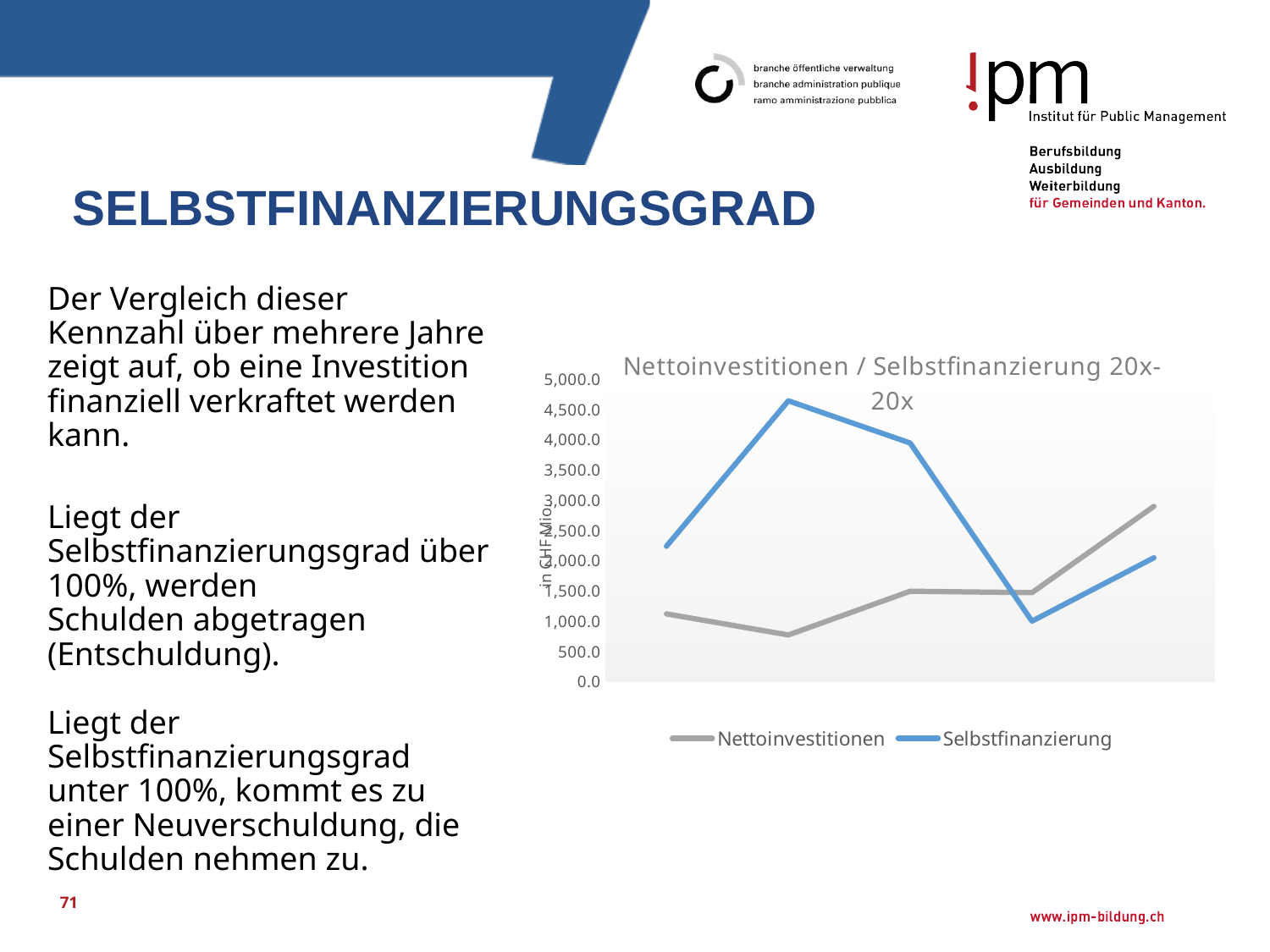
Does the Nettoinvestitionen line end higher or lower than it starts? higher Is the lowest value of the Nettoinvestitionen line greater or less than 1,000? less What are the two series named in the chart legend? Nettoinvestitionen and Selbstfinanzierung At which data point (first to fifth) does the Selbstfinanzierung line reach its highest value? second Is the last value of the Nettoinvestitionen line greater or less than 2,500? greater What kind of chart is shown on the slide? line chart How many data points does each line in the chart have? 5 What is the title of the chart? Nettoinvestitionen / Selbstfinanzierung 20x-20x Is the highest value of the Selbstfinanzierung line greater or less than 4,500? greater How many series does the chart legend list? 2 At the first data point, which series has the higher value, Nettoinvestitionen or Selbstfinanzierung? Selbstfinanzierung At the last data point, which series has the higher value, Nettoinvestitionen or Selbstfinanzierung? Nettoinvestitionen